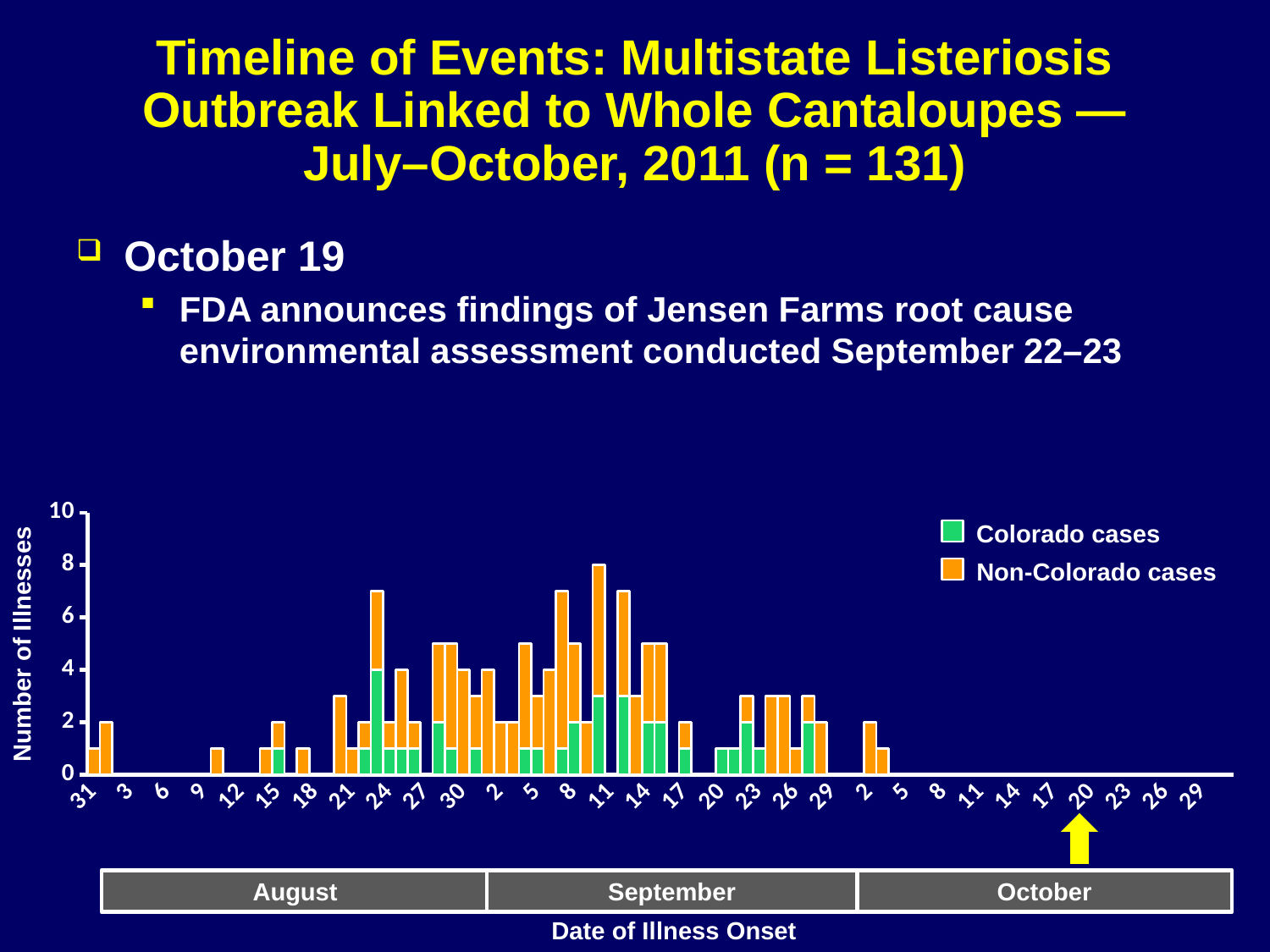
What are the two series named in the legend? Colorado cases and Non-Colorado cases On which date of illness onset is the tallest bar? September 10 How many months are labeled along the x axis? 3 How many illnesses does the tallest bar (September 11) reach on the axis? 8 How many series does the legend list? 2 What kind of chart is shown on the slide? stacked bar chart What is the label of the vertical axis? Number of Illnesses Is the number of illnesses on October 2 greater or less than 4? less What is the highest value shown on the vertical axis? 10